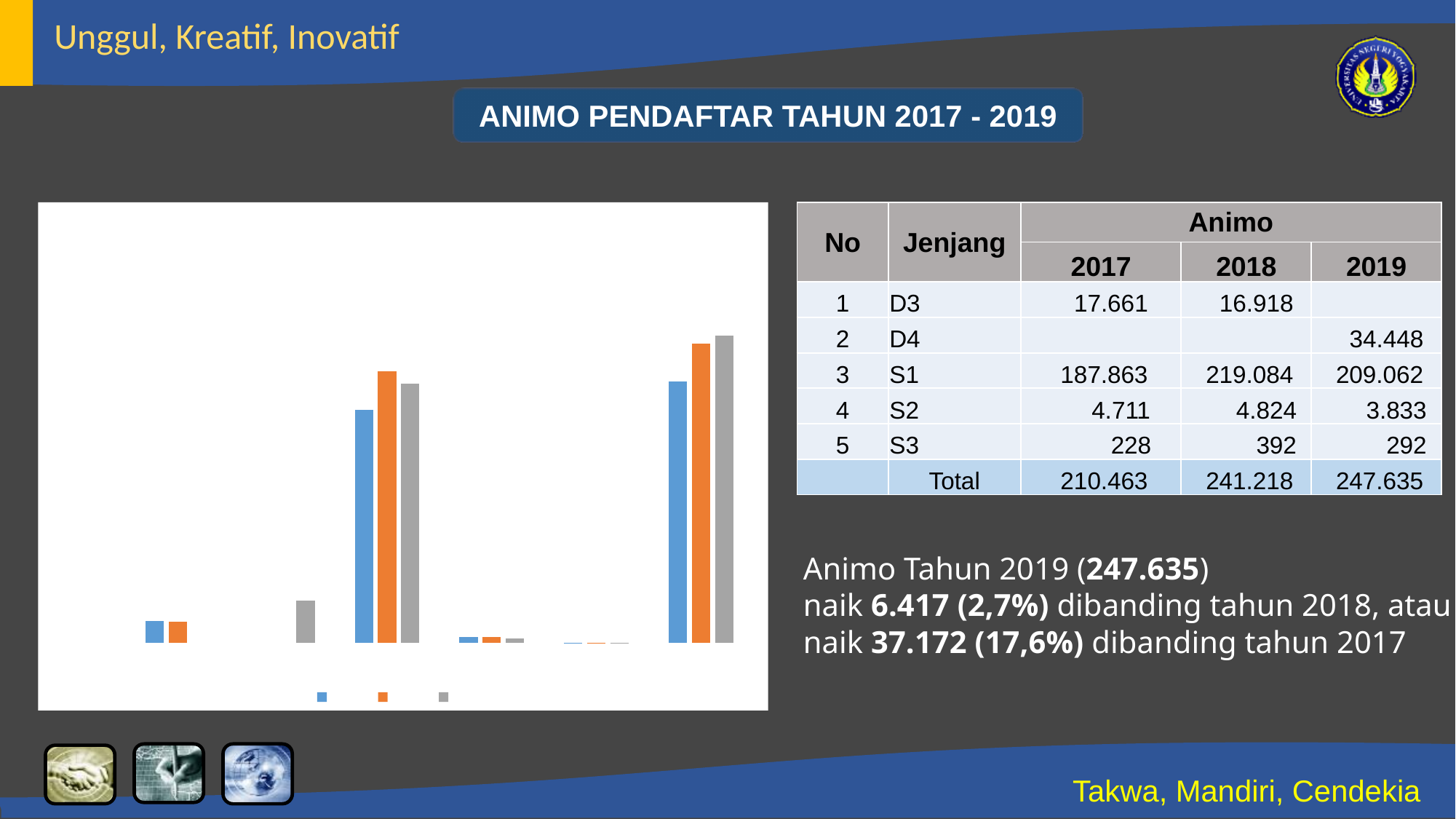
What three colours are used for the series in the bar chart? blue, orange and grey In the third group from the left of the bar chart, which coloured bar is the shortest? blue In the bar chart, is the blue bar in the third group taller or shorter than the blue bar in the rightmost group? shorter Which group of bars in the bar chart is the tallest? the rightmost group What kind of chart is shown on the left of the slide? bar chart How many series does the legend of the bar chart show? 3 How many bars are visible in the leftmost group of the bar chart? 2 In the third group from the left of the bar chart, which coloured bar is the tallest? orange How many groups of bars are plotted in the bar chart? 6 In the rightmost group of the bar chart, which coloured bar is the tallest? grey How many bars are visible in the second group from the left of the bar chart? 1 Where is the legend positioned in the bar chart? at the bottom